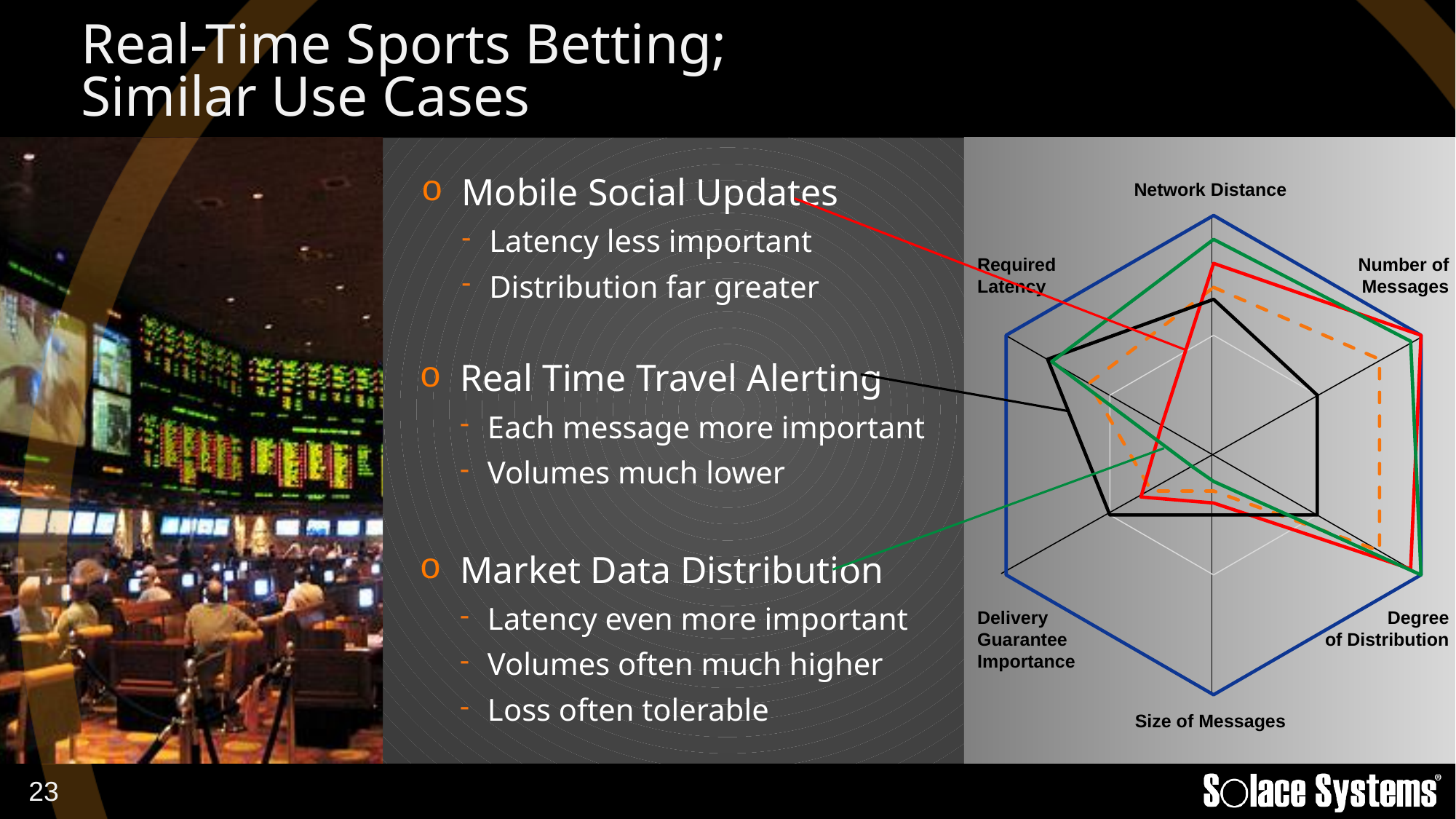
On the Network Distance axis, which series extends further out: the green line or the black line? Green Among the red, green and black series, which reaches furthest out on the Network Distance axis? Green Which axis of the radar chart is labelled at the bottom? Size of Messages On the Required Latency axis, which series extends further out: the black line or the red line? Black How many axes (categories) does the radar chart have? 6 What kind of chart is shown on the right side of the slide? Radar chart On the Degree of Distribution axis, which series extends further out: the green line or the black line? Green Among the red, green and black series, which is closest to the centre on the Degree of Distribution axis? Black Which axis of the radar chart is labelled at the top? Network Distance Among the red, green and black series, which is closest to the centre on the Number of Messages axis? Black